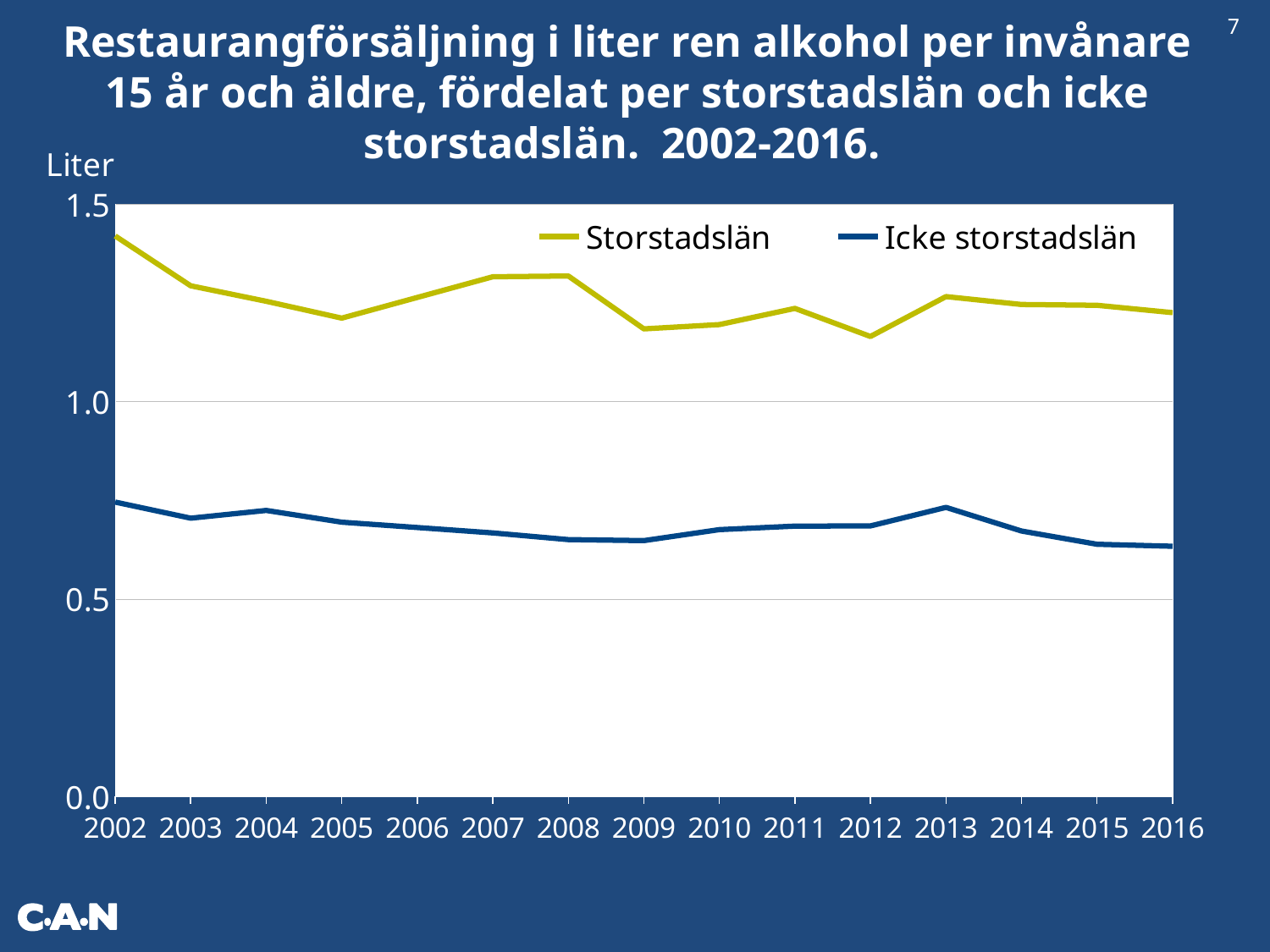
Which two series are listed in the legend? Storstadslän and Icke storstadslän Is the value for Storstadslän in 2002 greater or less than 1.0? greater Is the value for Storstadslän in 2012 greater or less than 1.5? less How many years are plotted along the x axis? 15 In which year does the Storstadslän series reach its highest value? 2002 What is the label on the y axis? Liter How many series does the legend list? 2 Is the value for Icke storstadslän in 2016 greater or less than 1.0? less Does the Storstadslän series rise or fall from 2002 to 2005? Fall What kind of chart is shown on the slide? Line chart In 2010, which series has the higher value, Storstadslän or Icke storstadslän? Storstadslän